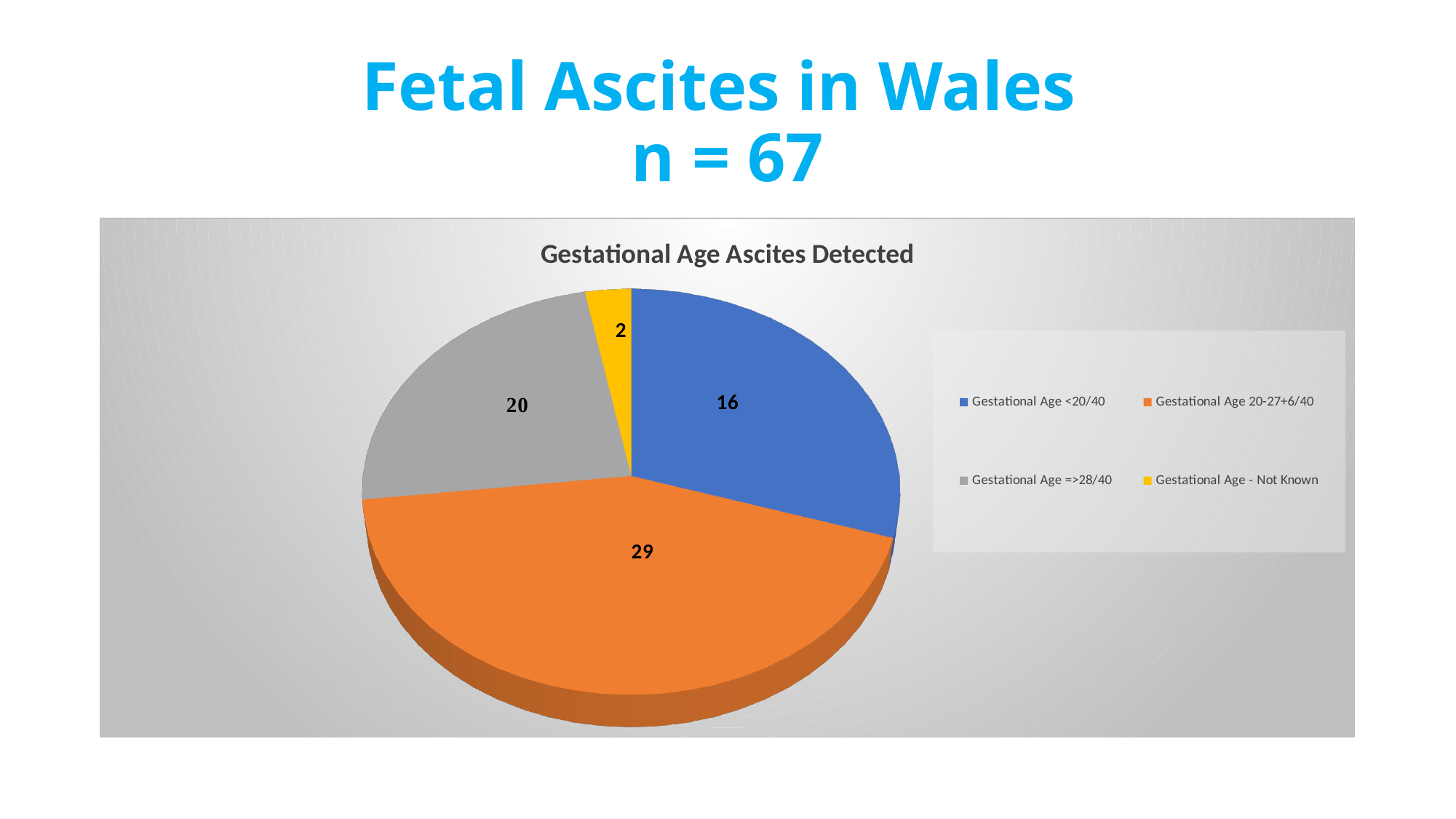
How many cases are in the Gestational Age <20/40 category? 16 What is the title of the chart? Gestational Age Ascites Detected Which category has the largest slice of the pie? Gestational Age 20-27+6/40 How many cases are in the Gestational Age - Not Known category? 2 What type of chart is shown on the slide? Pie chart Which is larger: Gestational Age =>28/40 or Gestational Age <20/40? Gestational Age =>28/40 What colour is the slice for Gestational Age - Not Known? Yellow How many cases are in the Gestational Age 20-27+6/40 category? 29 How many categories does the pie chart have? 4 How many cases are in the Gestational Age =>28/40 category? 20 What is the difference between the Gestational Age 20-27+6/40 and Gestational Age <20/40 values? 13 Which category has the smallest slice of the pie? Gestational Age - Not Known